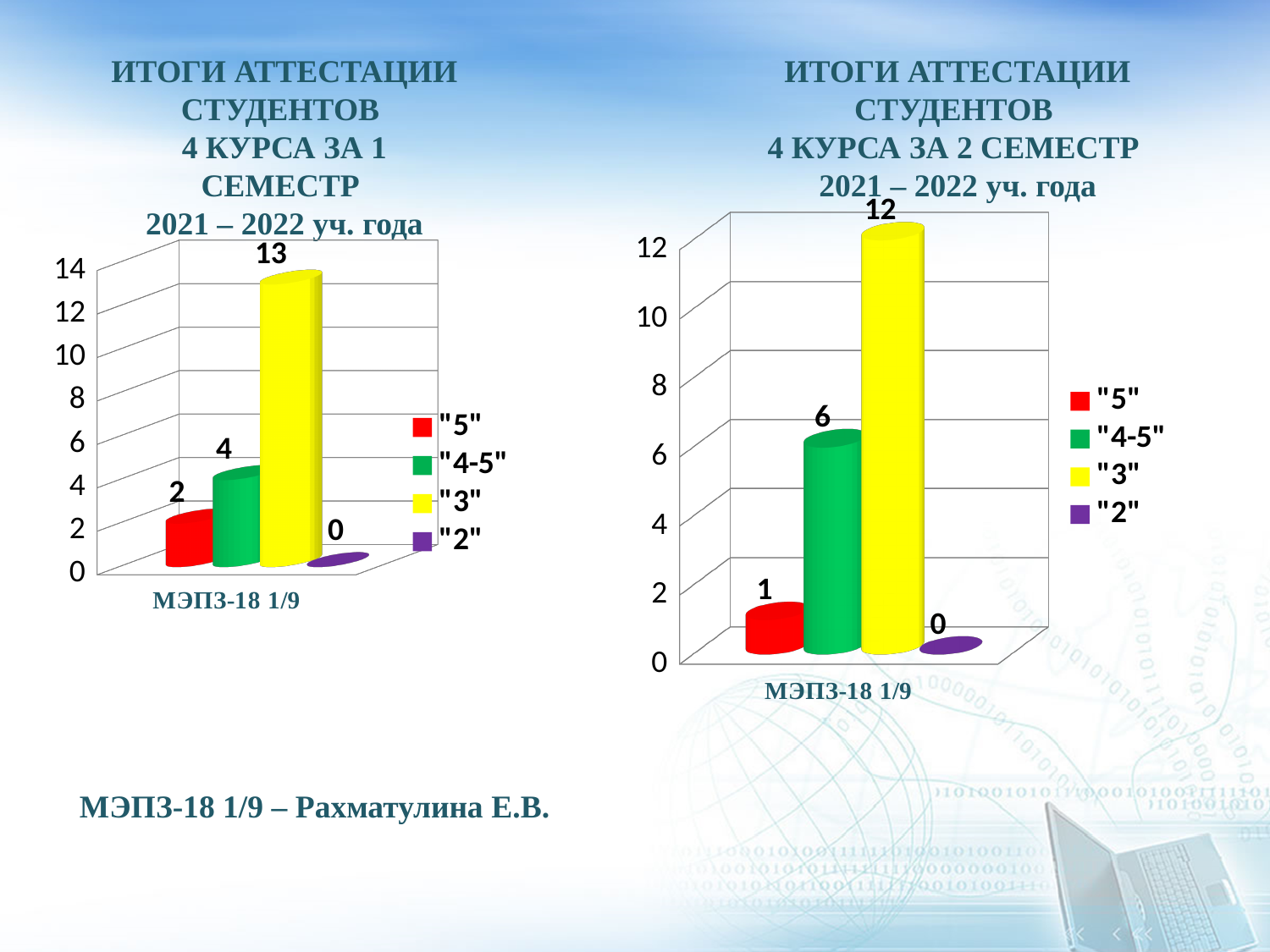
In the left chart (1 семестр), what is the value for the "3" series? 13 In the right chart (2 семестр), what is the value for the "4-5" series? 6 In the left chart (1 семестр), is the value for "3" greater or less than 10? greater In the right chart (2 семестр), which is larger: the value for "5" or the value for "4-5"? "4-5" In the left chart (1 семестр), which series has the highest value? "3" What kind of chart is the left chart (1 семестр)? bar chart How many series does the legend of the right chart (2 семестр) list? 4 What is the category label shown on the x axis of the right chart (2 семестр)? МЭПЗ-18 1/9 In the right chart (2 семестр), which series has the lowest value? "2" In the left chart (1 семестр), what is the difference between the "3" and "4-5" values? 9 In the right chart (2 семестр), what is the difference between the "3" and "4-5" values? 6 In the right chart (2 семестр), what is the value for the "5" series? 1